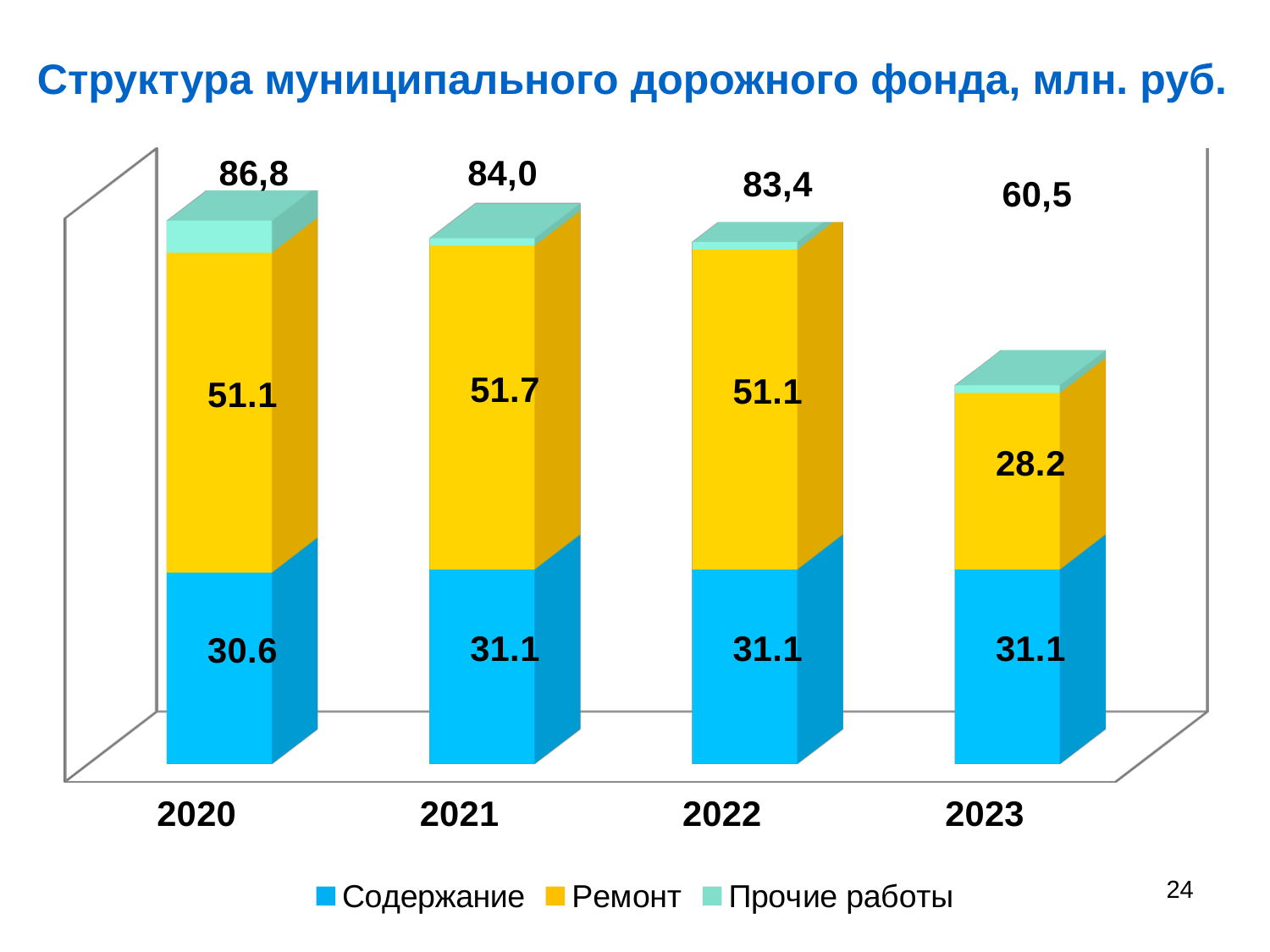
What is the difference between the Ремонт values for 2021 and 2023? 23.5 Which year has the highest total value? 2020 What is the value for Содержание in 2020? 30.6 Do the total values rise or fall from 2020 to 2023? Fall Which year has the lowest total value? 2023 What is the value for Ремонт in 2023? 28.2 Which is larger: the Ремонт value in 2021 or in 2022? 2021 What is the value for Ремонт in 2021? 51.7 How many years are shown on the x axis? 4 What is the total of the stacked bar for 2022? 83,4 What kind of chart is shown on the slide? Stacked bar chart How many series does the legend list? 3